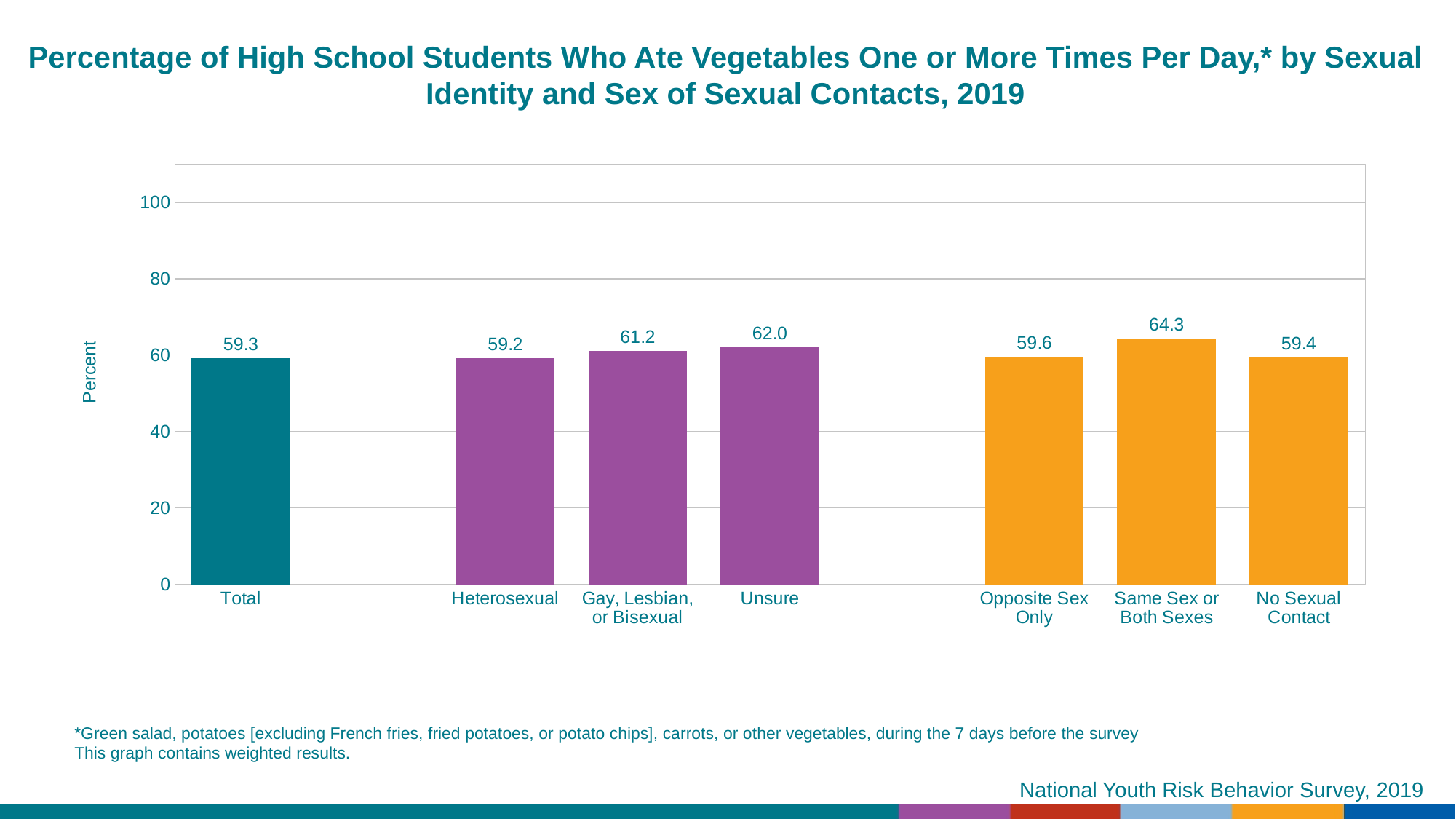
What percentage of students in the Total category ate vegetables one or more times per day? 59.3 What is the value for Gay, Lesbian, or Bisexual students? 61.2 Which category has the lowest percentage? Heterosexual What kind of chart is shown on the slide? bar chart Is the value for No Sexual Contact greater or less than 80? less What is the value for students with Same Sex or Both Sexes sexual contacts? 64.3 How many categories are shown on the chart? 7 What is the difference between the values for Same Sex or Both Sexes and Opposite Sex Only? 4.7 What is the value for Heterosexual students? 59.2 Which category has the highest percentage? Same Sex or Both Sexes What is the value for students who are Unsure of their sexual identity? 62.0 Which is larger, the value for Unsure or the value for Heterosexual? Unsure